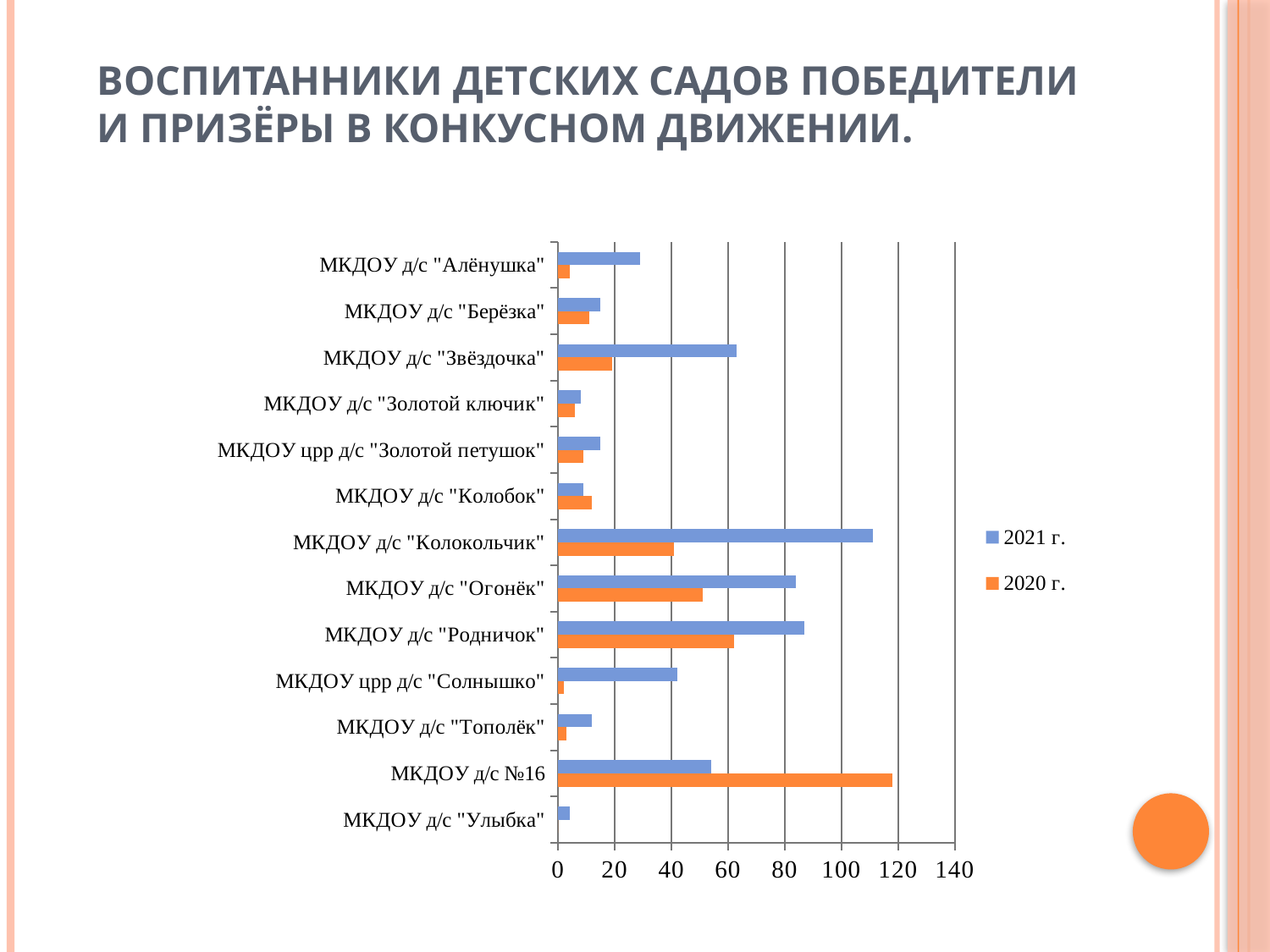
Is the 2020 г. value for МКДОУ црр д/с "Солнышко" greater or less than 20? less Which kindergarten has the highest value for 2020 г.? МКДОУ д/с №16 What kind of chart is shown on the slide? bar chart How many kindergartens (categories) are listed on the chart? 13 For МКДОУ д/с "Огонёк", which year has the larger value, 2021 г. or 2020 г.? 2021 г. Which series are listed in the legend? 2021 г. and 2020 г. Is the 2021 г. value for МКДОУ д/с "Колокольчик" greater or less than 100? greater How many series does the legend list? 2 Which kindergarten has the highest value for 2021 г.? МКДОУ д/с "Колокольчик" Is the 2020 г. value for МКДОУ д/с №16 greater or less than 100? greater For МКДОУ д/с №16, which year has the larger value, 2021 г. or 2020 г.? 2020 г.